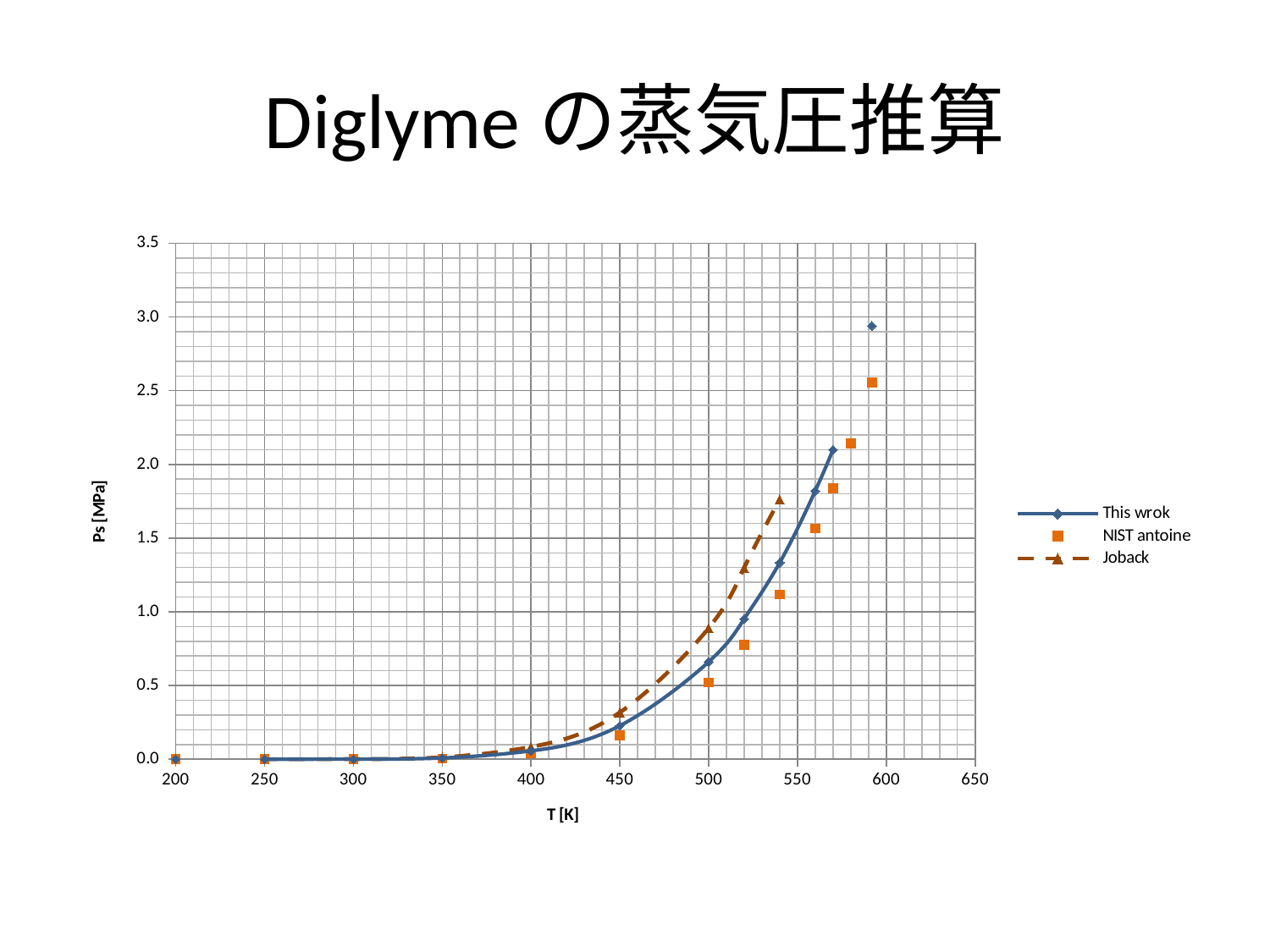
What kind of chart is shown on the slide? line chart How many series does the legend list? 3 Is the value of the 'NIST antoine' series at 500 K greater or less than 1.0? less Is the value of the 'Joback' series at 540 K greater or less than 1.5? greater At 540 K, which series has the larger value, 'Joback' or 'This wrok'? Joback Is the value of the 'This wrok' series at 500 K greater or less than 1.0? less Do the values of the 'This wrok' series rise or fall as T increases? rise What is the label of the vertical axis? Ps [MPa] What is the label of the horizontal axis? T [K] At about 590 K, which series has the larger value, 'This wrok' or 'NIST antoine'? This wrok